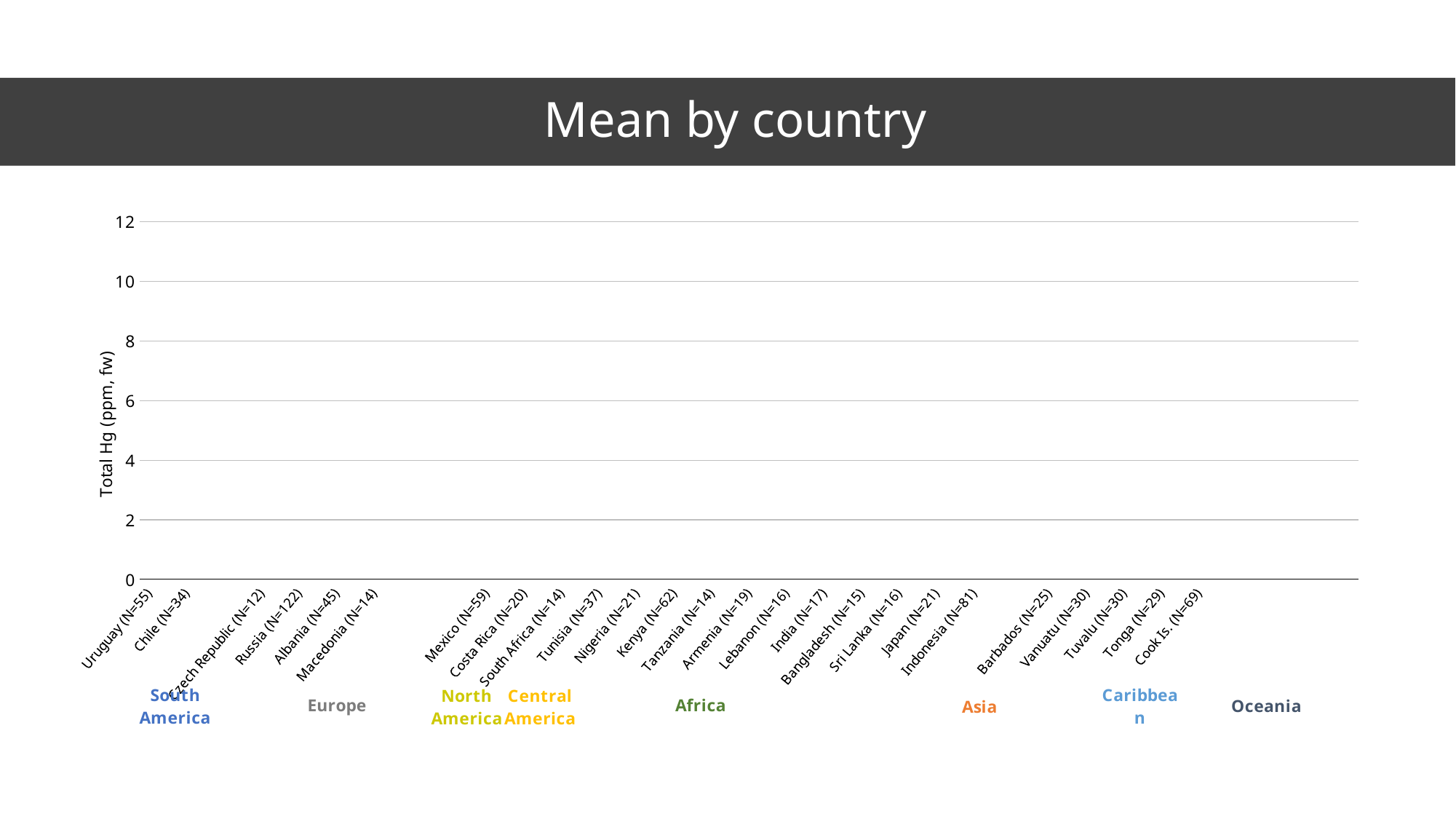
What is the label on the y axis of the chart? Total Hg (ppm, fw) What sample size (N) is shown in the x-axis label for Cook Is.? N=69 What sample size (N) is shown in the x-axis label for Russia? N=122 What is the highest value shown on the y axis of the chart? 12 How many countries are listed along the x axis of the chart? 25 What sample size (N) is shown in the x-axis label for Indonesia? N=81 What is the title of the chart? Mean by country What sample size (N) is shown in the x-axis label for Uruguay? N=55